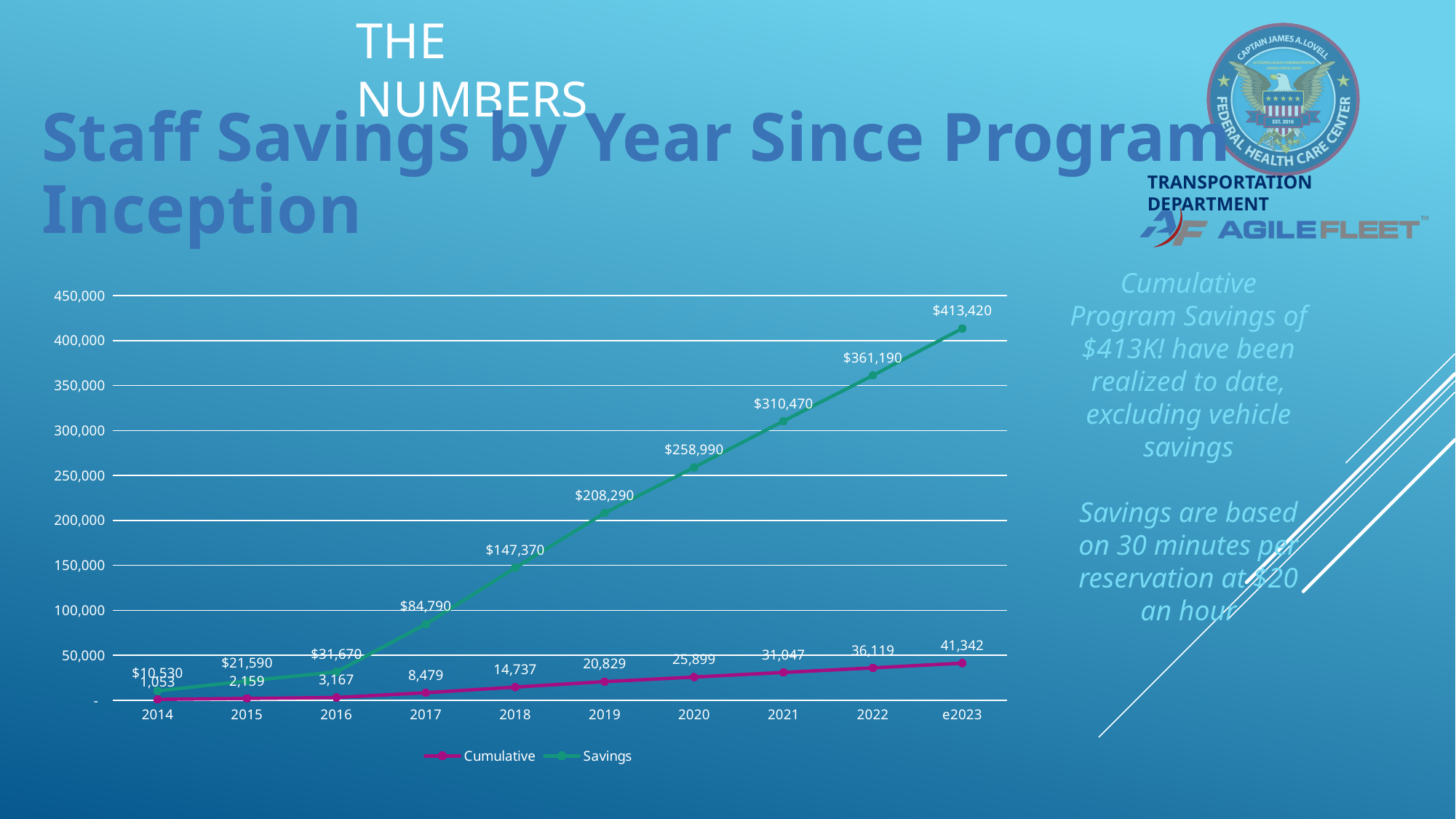
What is the Savings value for e2023? $413,420 Which year has the lowest Savings value? 2014 Which colour is used for the Savings series in the chart? green How many years are plotted along the x axis of the chart? 10 Do the Savings values rise or fall from 2014 to e2023? rise Which year has the highest Cumulative value? e2023 What is the Cumulative value for 2020? 25,899 Which is larger, the Savings value for 2017 or for 2016? 2017 How many series does the chart legend list? 2 What is the difference between the Savings values for 2022 and 2021? $50,720 What type of chart is shown on the slide? line chart What is the Savings value for 2018? $147,370